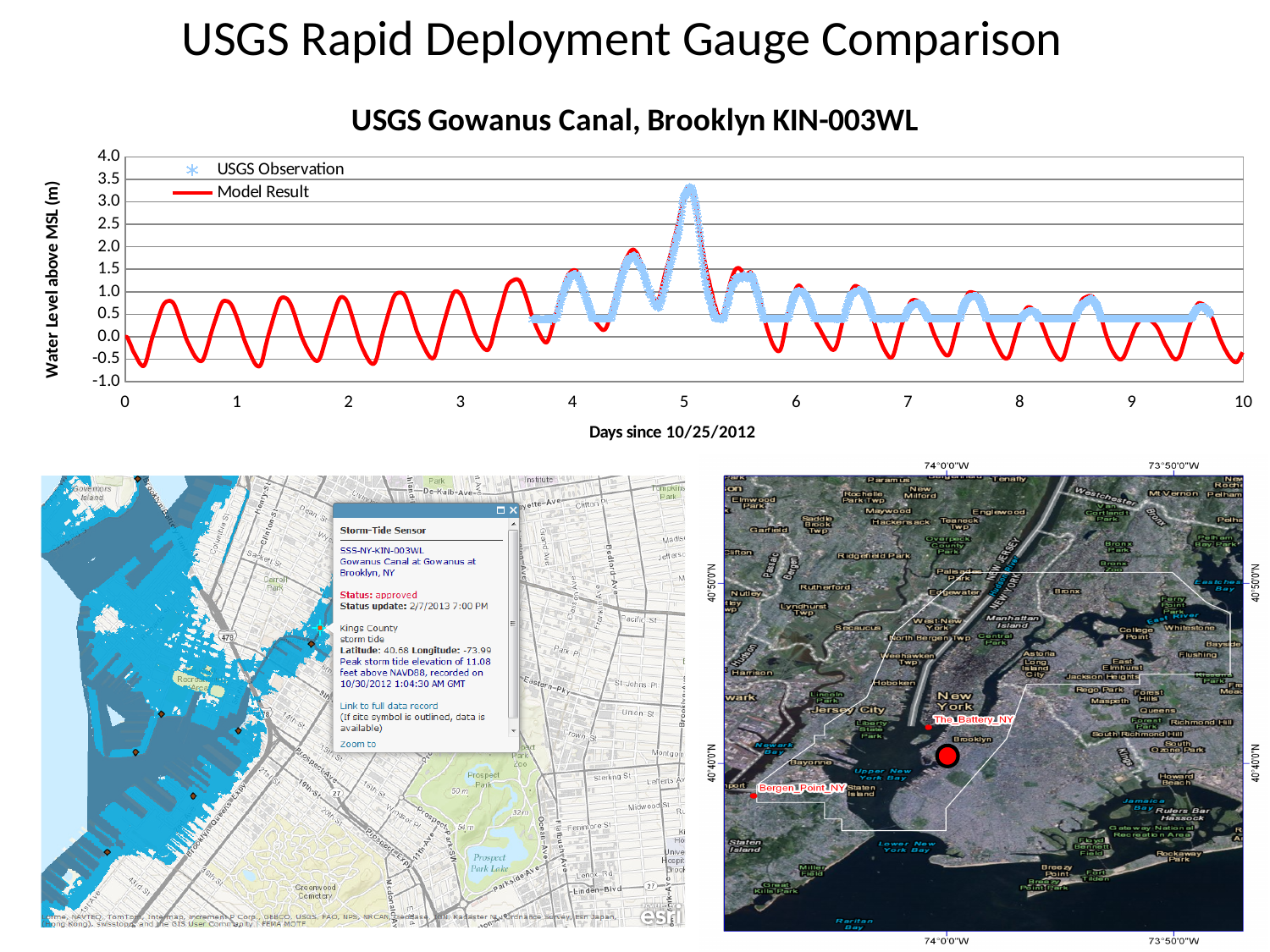
Which series is drawn as a red line? Model Result Is the peak value of the USGS Observation series greater or less than 2.5? greater Is the lowest value of the Model Result series greater or less than 0.0? less Is the lowest value of the USGS Observation series greater or less than 0.0? greater What is the title of the chart? USGS Gowanus Canal, Brooklyn KIN-003WL What is the label of the chart's x axis? Days since 10/25/2012 How many series does the chart legend list? 2 What kind of chart is shown on the slide? line chart